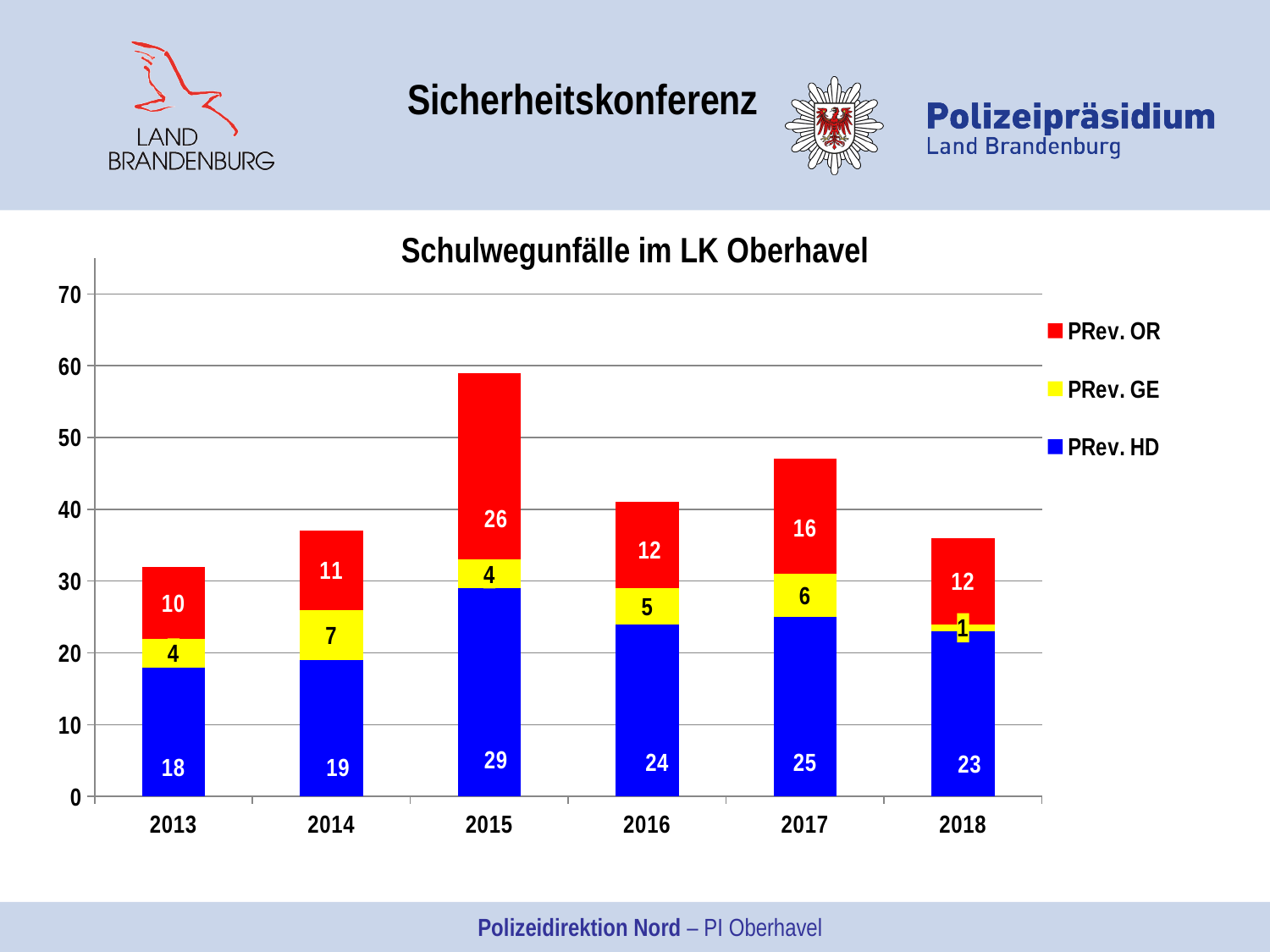
In which year is the PRev. HD value lowest? 2013 What is the difference between the PRev. OR values for 2015 and 2016? 14 How many series does the legend list? 3 What is the value for PRev. OR in 2017? 16 How many years are shown on the x axis? 6 What is the value for PRev. HD in 2015? 29 In which year is the PRev. OR value highest? 2015 What is the value for PRev. GE in 2018? 1 What is the title of the chart? Schulwegunfälle im LK Oberhavel What type of chart is shown on the slide? Stacked bar chart What is the total of the stacked bar for 2015? 59 Which is larger, the PRev. GE value in 2014 or in 2017? 2014